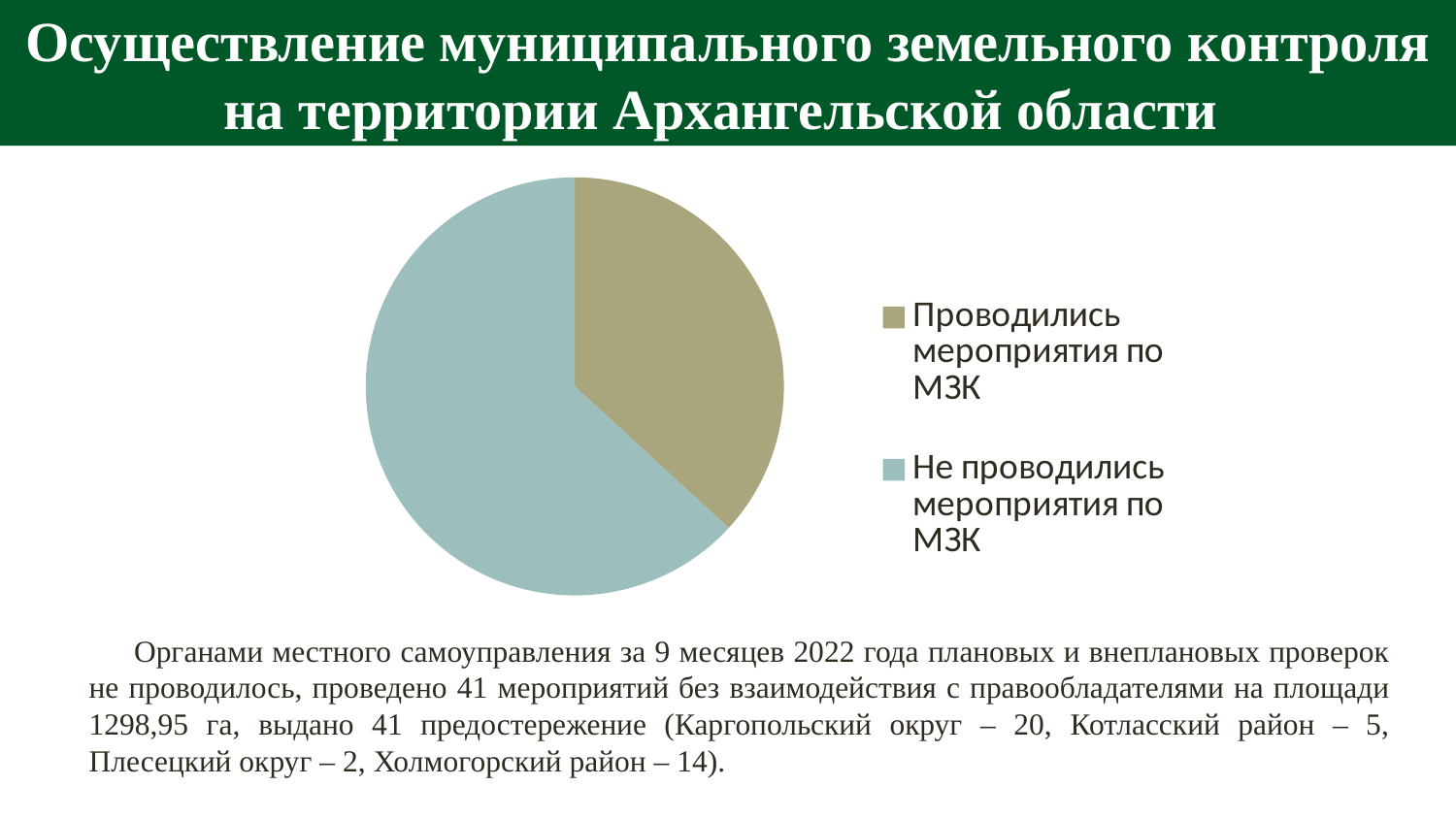
How many entries does the legend of the pie chart list? 2 Which slice of the pie chart is the smallest? Проводились мероприятия по МЗК Which slice of the pie chart is the largest? Не проводились мероприятия по МЗК What colour is the slice for "Не проводились мероприятия по МЗК"? Light blue-green What kind of chart is shown on the slide? Pie chart Does the slice "Проводились мероприятия по МЗК" take up more or less than half of the pie? Less How many slices does the pie chart have? 2 What is the first legend entry of the pie chart? Проводились мероприятия по МЗК Which slice is larger: "Проводились мероприятия по МЗК" or "Не проводились мероприятия по МЗК"? Не проводились мероприятия по МЗК